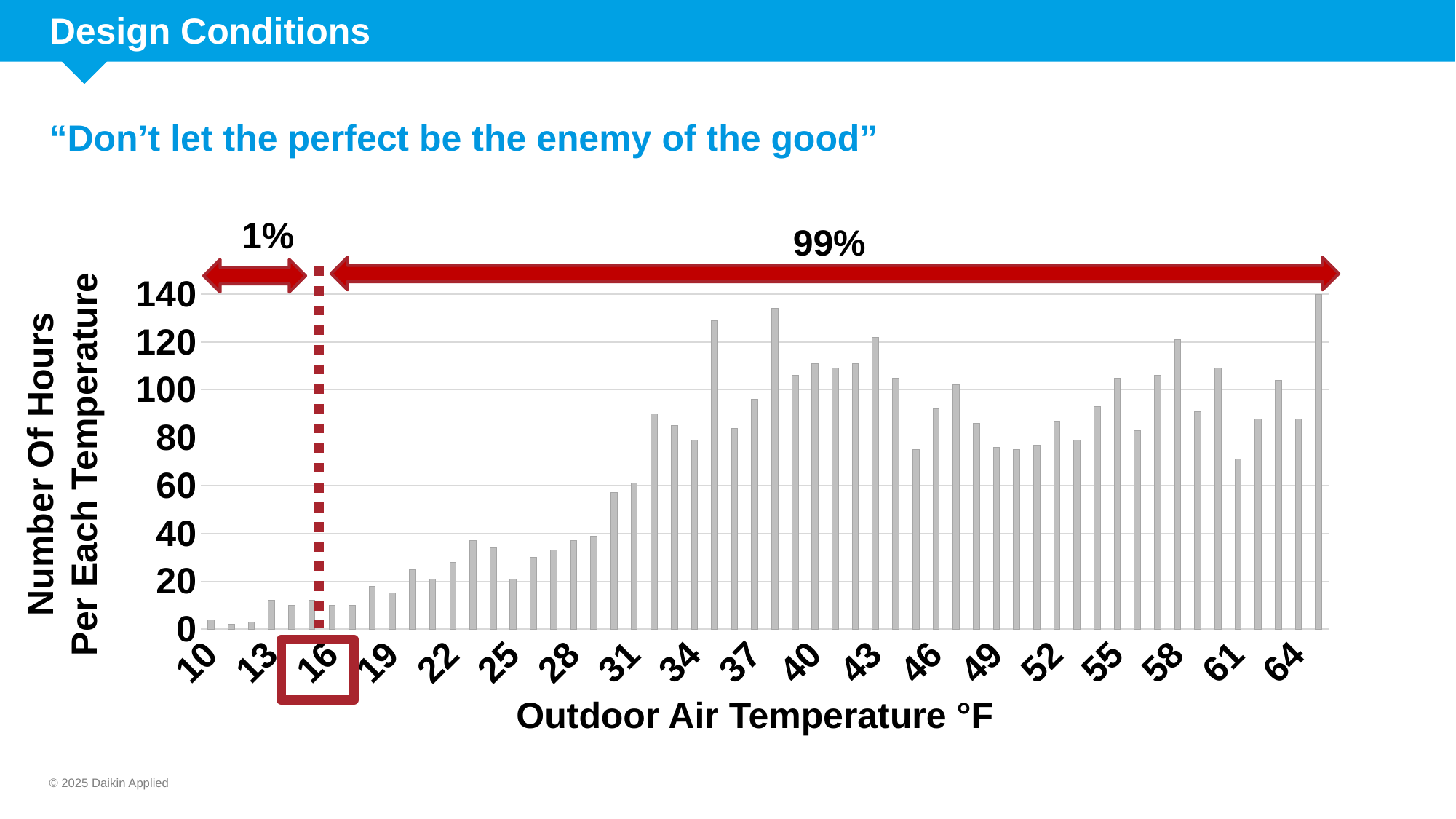
What is the title of the x axis of the chart? Outdoor Air Temperature °F Is the value for 22 °F greater or less than 60? less Which has the larger value, 10 °F or 40 °F? 40 °F Do the values generally rise or fall as the temperature increases from 10 °F to 40 °F? rise What kind of chart is shown on the slide? bar chart Is the value for 31 °F greater or less than 20? greater Is the value for 10 °F greater or less than 20? less What is the title of the y axis of the chart? Number Of Hours Per Each Temperature